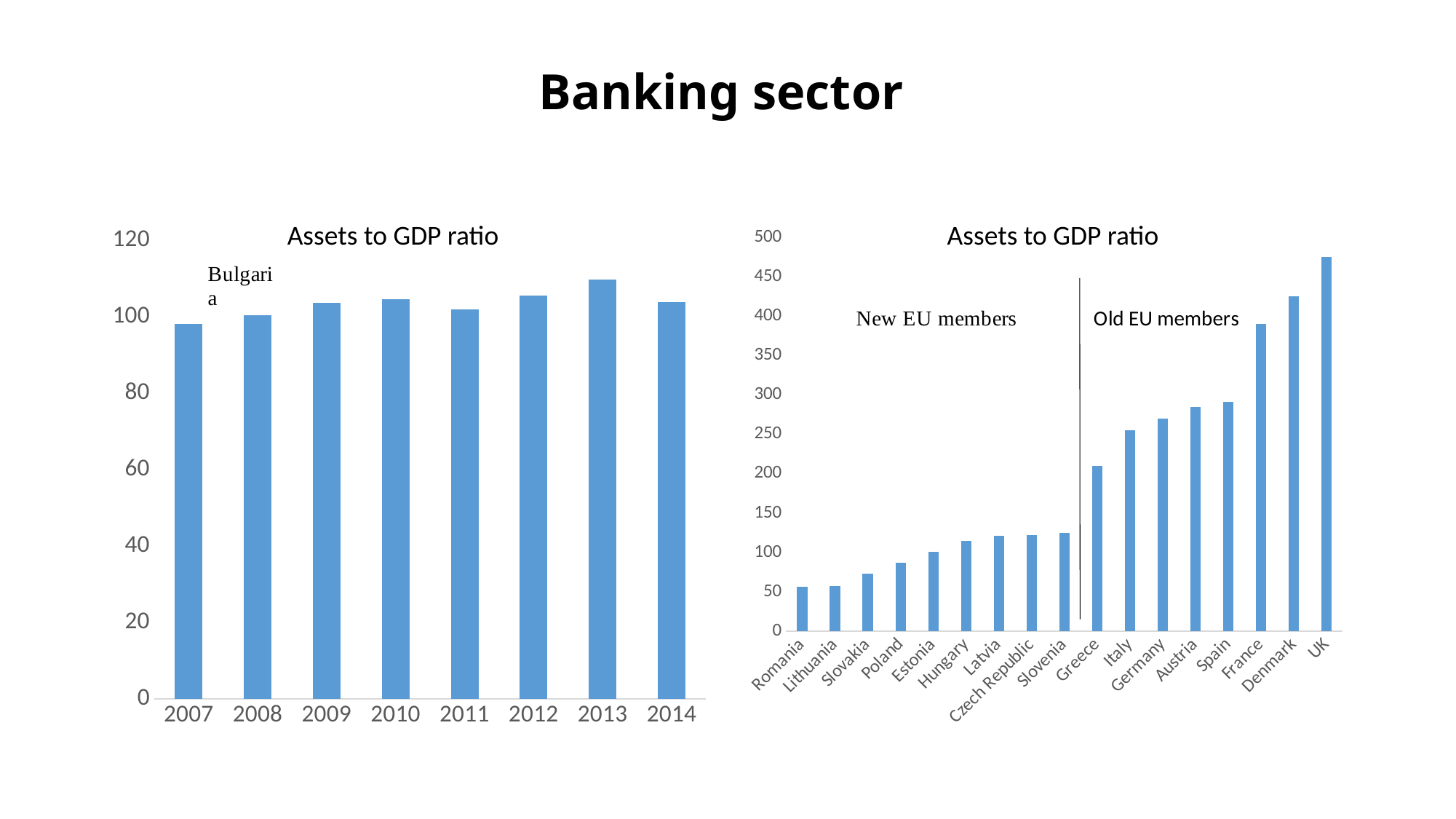
On the right chart, is the value for UK greater or less than 450? greater On the right chart, which country has the highest assets to GDP ratio? UK What kind of chart is the right chart? bar chart On the right chart, which is larger, the value for Greece or the value for Slovenia? Greece On the left chart, which country is the data for? Bulgaria On the left chart, how many years are plotted? 8 On the right chart, is the value for France greater or less than 350? greater On the right chart, how many countries are plotted? 17 On the left chart, which year has the highest assets to GDP ratio? 2013 On the right chart, is the value for Romania greater or less than 100? less On the right chart, do the values generally rise or fall from left to right? rise